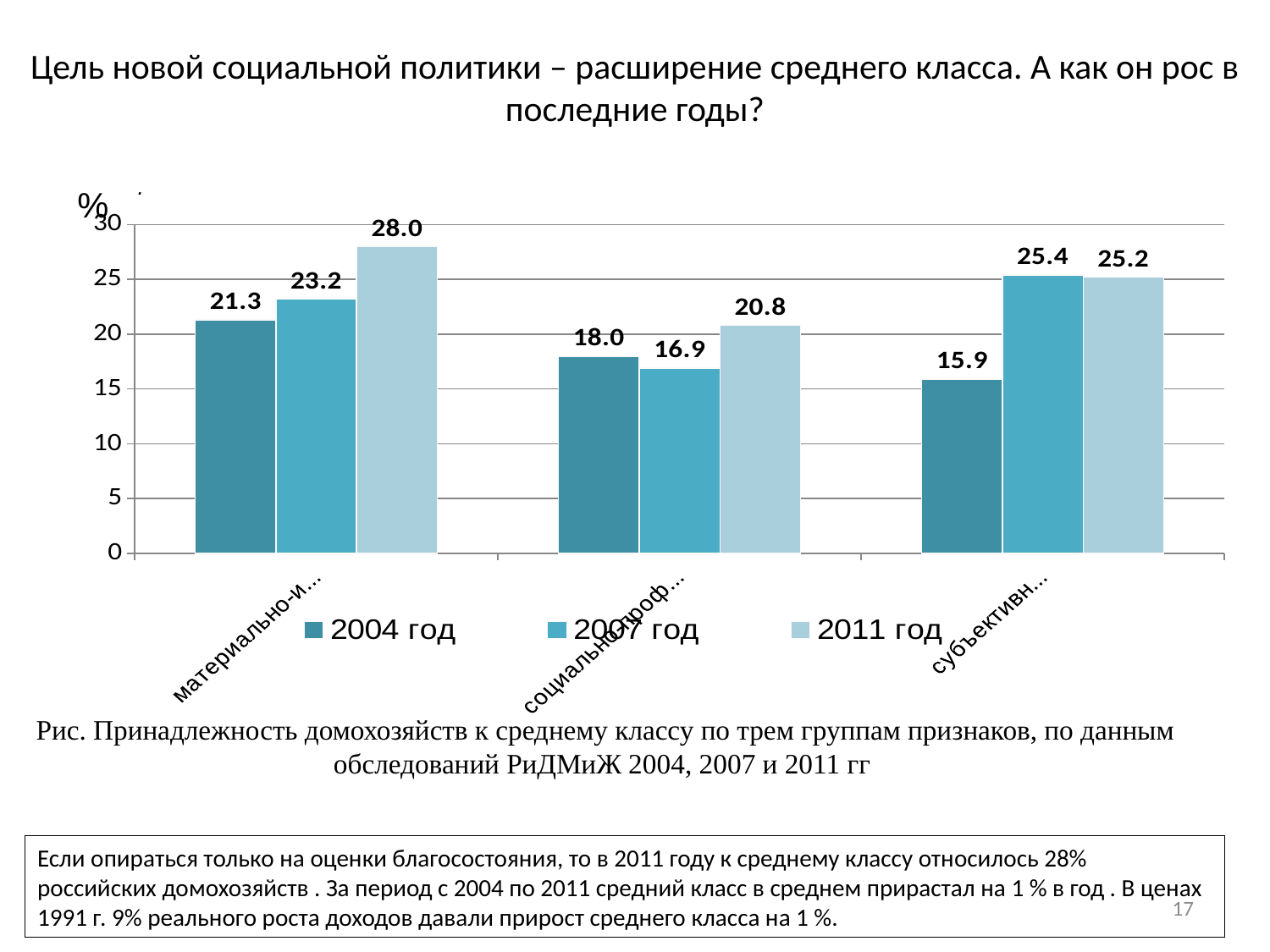
What kind of chart is shown on the slide? Bar chart What is the value for the 2011 год series in the leftmost group of bars (материально-и...)? 28.0 What are the three entries in the chart legend? 2004 год, 2007 год, 2011 год Which bar has the highest value on the chart? 2011 год in the leftmost group (28.0) In the rightmost group of bars, which is larger: the 2007 год value or the 2011 год value? 2007 год (25.4) In the leftmost group of bars, do the values rise or fall from 2004 год to 2011 год? Rise What is the value for the 2007 год series in the middle group of bars (социально-проф...)? 16.9 How many groups of bars (categories) are shown on the x axis? 3 What is the value for the 2004 год series in the rightmost group of bars (субъективн...)? 15.9 How many series does the legend list? 3 Which bar has the lowest value on the chart? 2004 год in the rightmost group (15.9) In the leftmost group of bars, what is the difference between the 2011 год value and the 2004 год value? 6.7